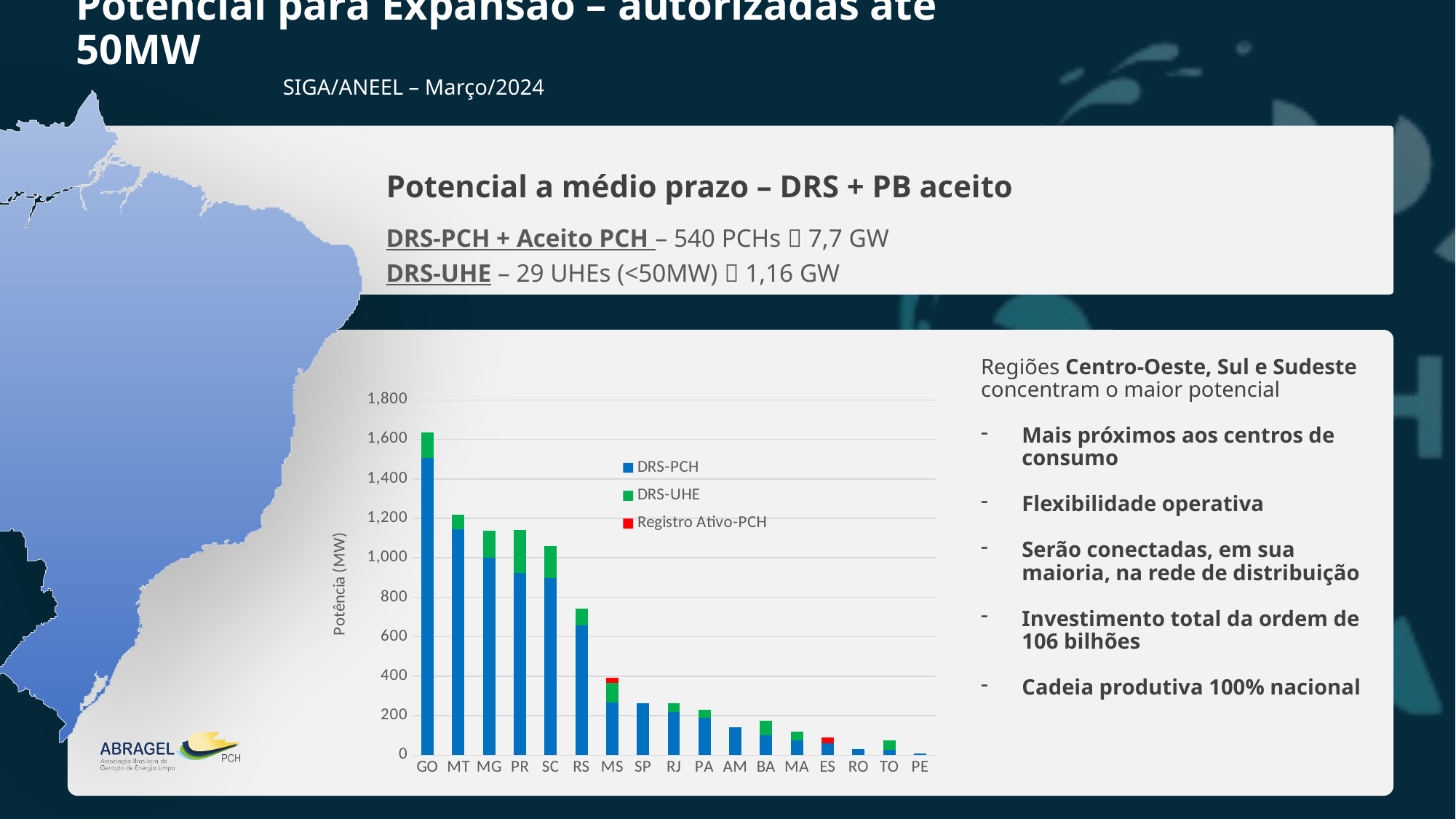
Is the total bar for MG greater or less than 1,000? greater How many states (categories) are shown on the x axis of the chart? 17 Is the total bar for GO greater or less than 1,400? greater Do the total bar values rise or fall moving from left to right along the x axis? fall What type of chart is shown on the slide? stacked bar chart Which state has the lowest total bar in the chart? PE Is the total bar for RS greater or less than 600? greater What is the label of the y axis of the chart? Potência (MW) Which has a larger total bar, GO or MT? GO How many series does the chart legend list? 3 Which state has the highest total bar in the chart? GO